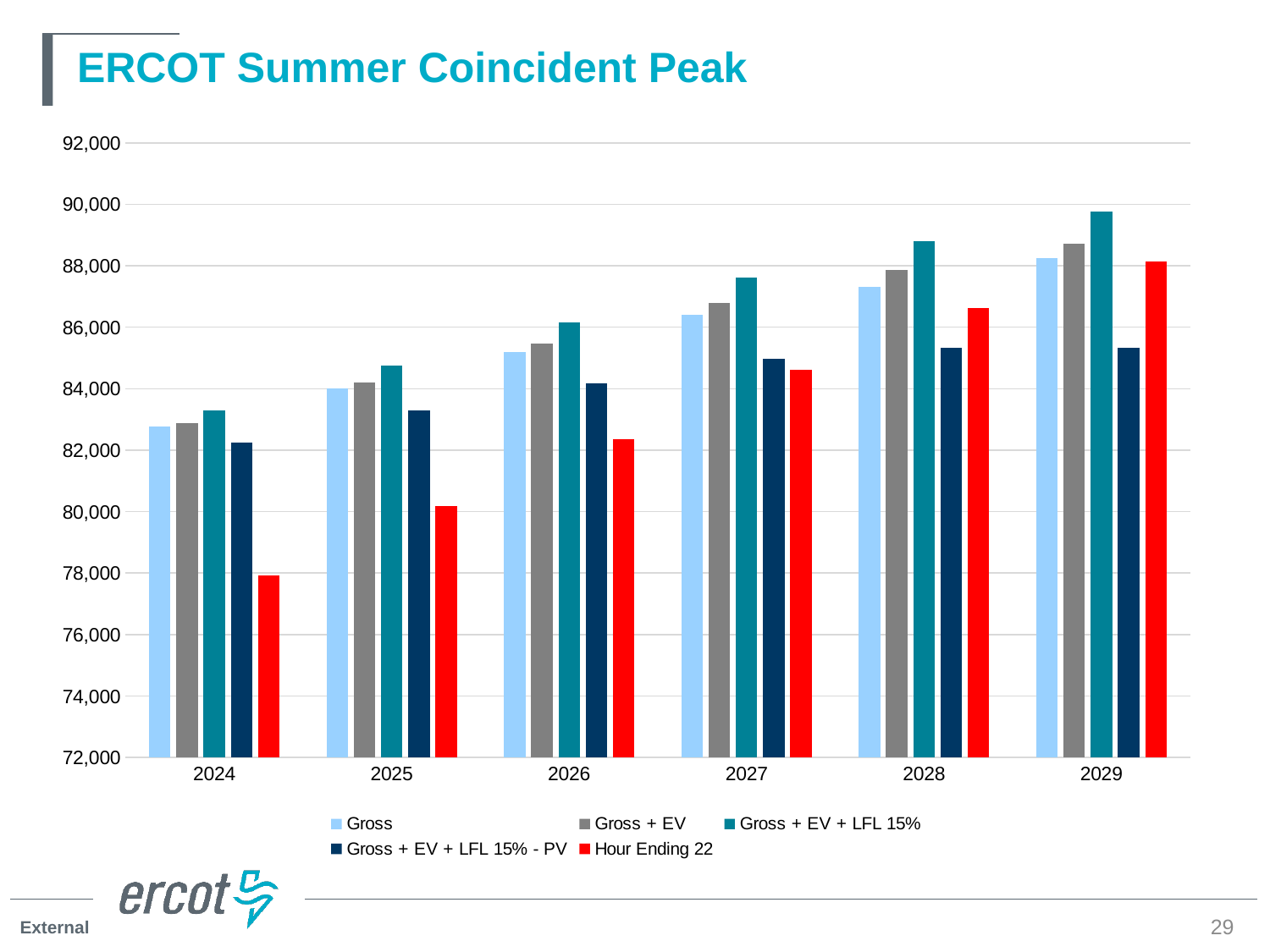
Is the Hour Ending 22 value for 2024 greater or less than 80,000? less Is the Gross + EV + LFL 15% - PV value for 2025 greater or less than 84,000? less In which year is the Hour Ending 22 value lowest? 2024 In 2024, which is larger: Gross or Hour Ending 22? Gross In which year is the Gross + EV + LFL 15% value highest? 2029 What kind of chart is shown on the slide? Bar chart Is the Gross + EV + LFL 15% value for 2029 greater or less than 90,000? less How many years are shown on the x axis? 6 In 2028, which is larger: Hour Ending 22 or Gross + EV + LFL 15% - PV? Hour Ending 22 Do the Gross values rise or fall from 2024 to 2029? Rise How many series does the legend list? 5